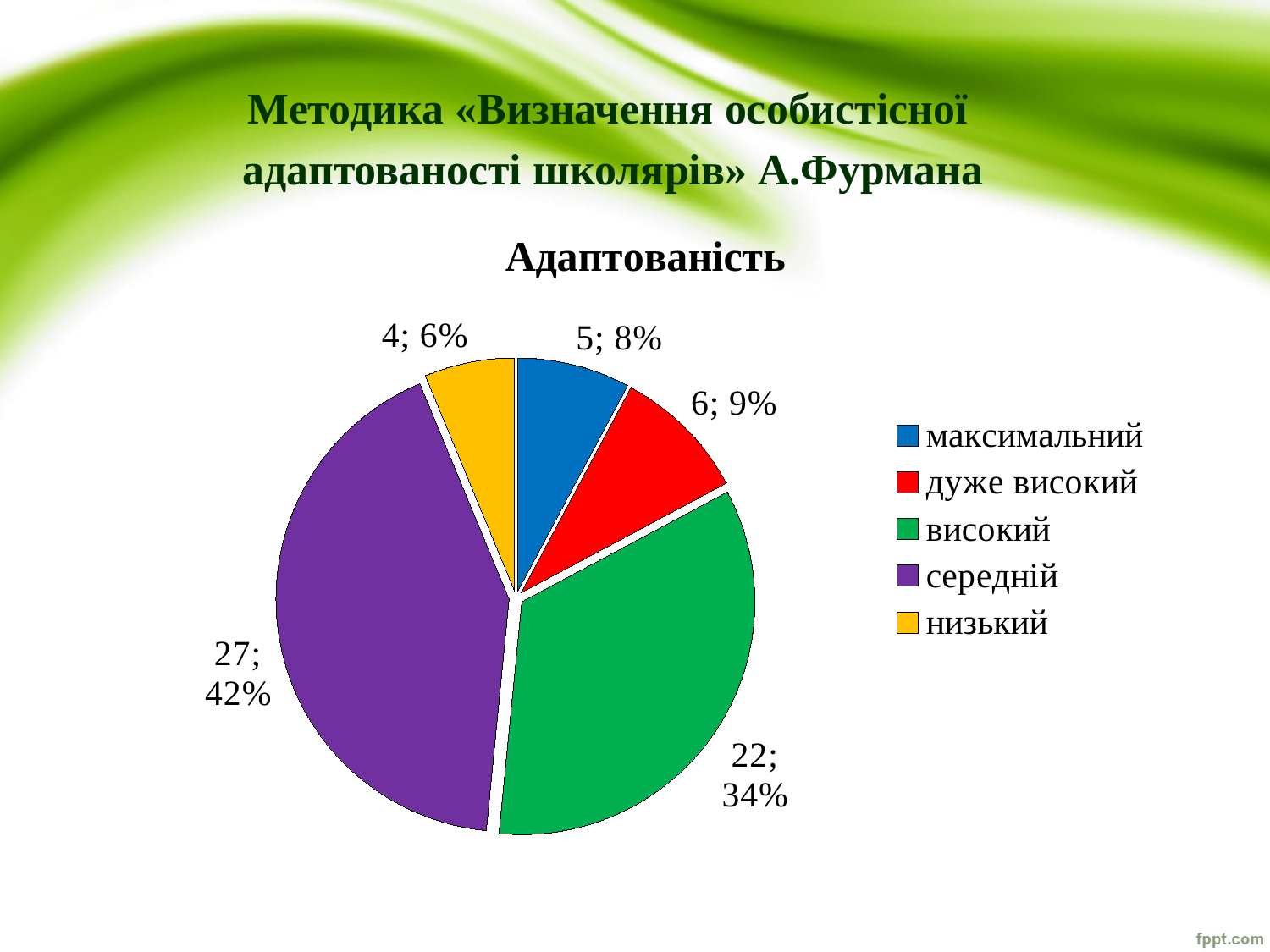
Which category has the largest slice? середній How many slices does the pie chart have? 5 What kind of chart is shown on the slide? pie chart What is the value for the 'максимальний' slice? 5 What is the value for the 'середній' slice? 27 What is the title of the chart? Адаптованість Which category has the smallest slice? низький What share of the pie does the 'низький' slice represent? 6% What share of the pie does the 'дуже високий' slice represent? 9% What is the value for the 'високий' slice? 22 What is the difference between the values for 'середній' and 'високий'? 5 How many entries does the legend list? 5